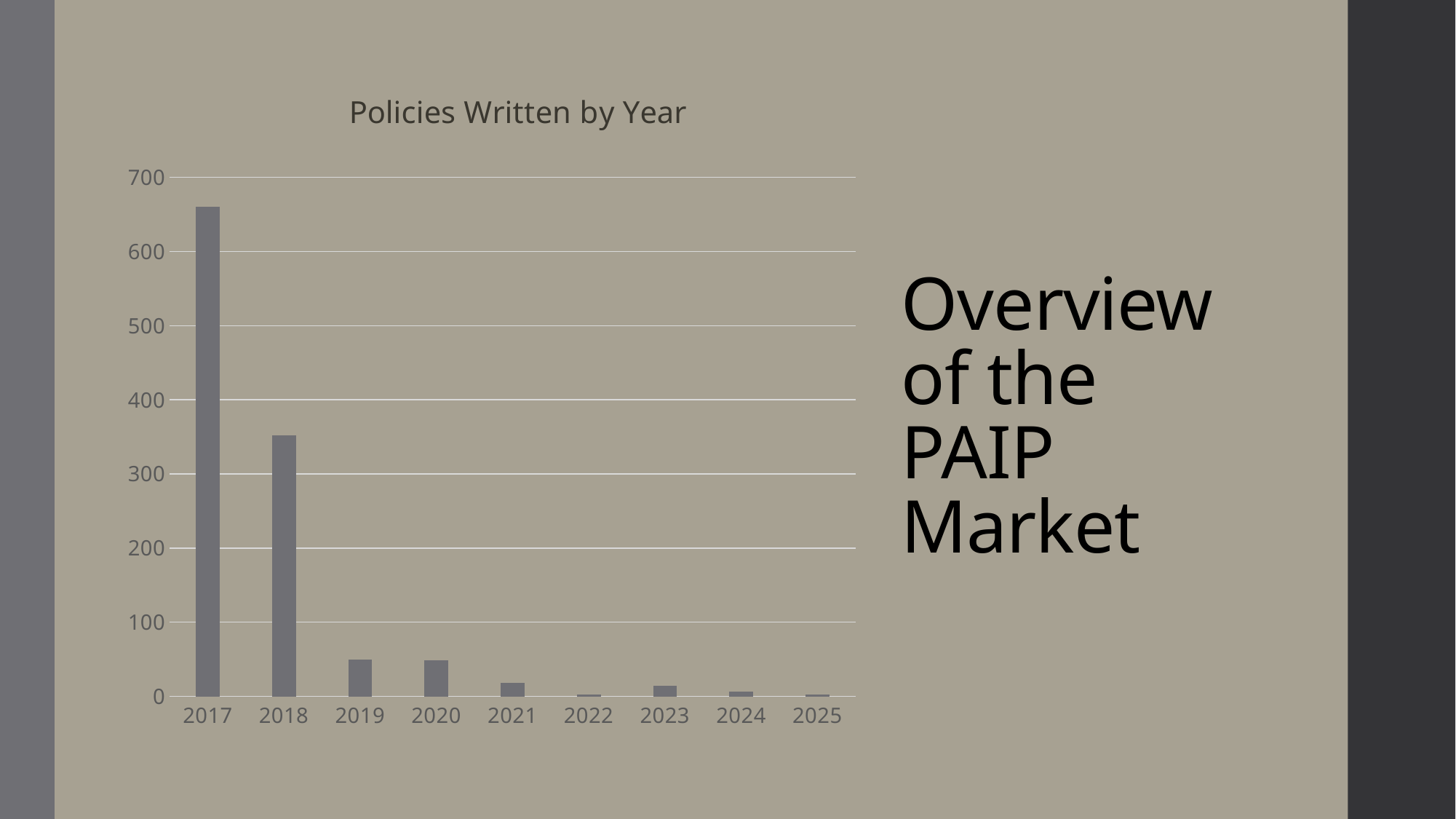
What kind of chart is shown on the slide? bar chart Which year has the highest number of policies written? 2017 Which year has the larger value, 2018 or 2019? 2018 Is the value for 2021 greater or less than 100? less Which year has the larger value, 2017 or 2018? 2017 Is the value for 2018 greater or less than 400? less How many years are shown on the x axis of the chart? 9 Is the value for 2018 greater or less than 300? greater Do the values generally rise or fall from 2017 to 2025? fall What is the title of the chart? Policies Written by Year